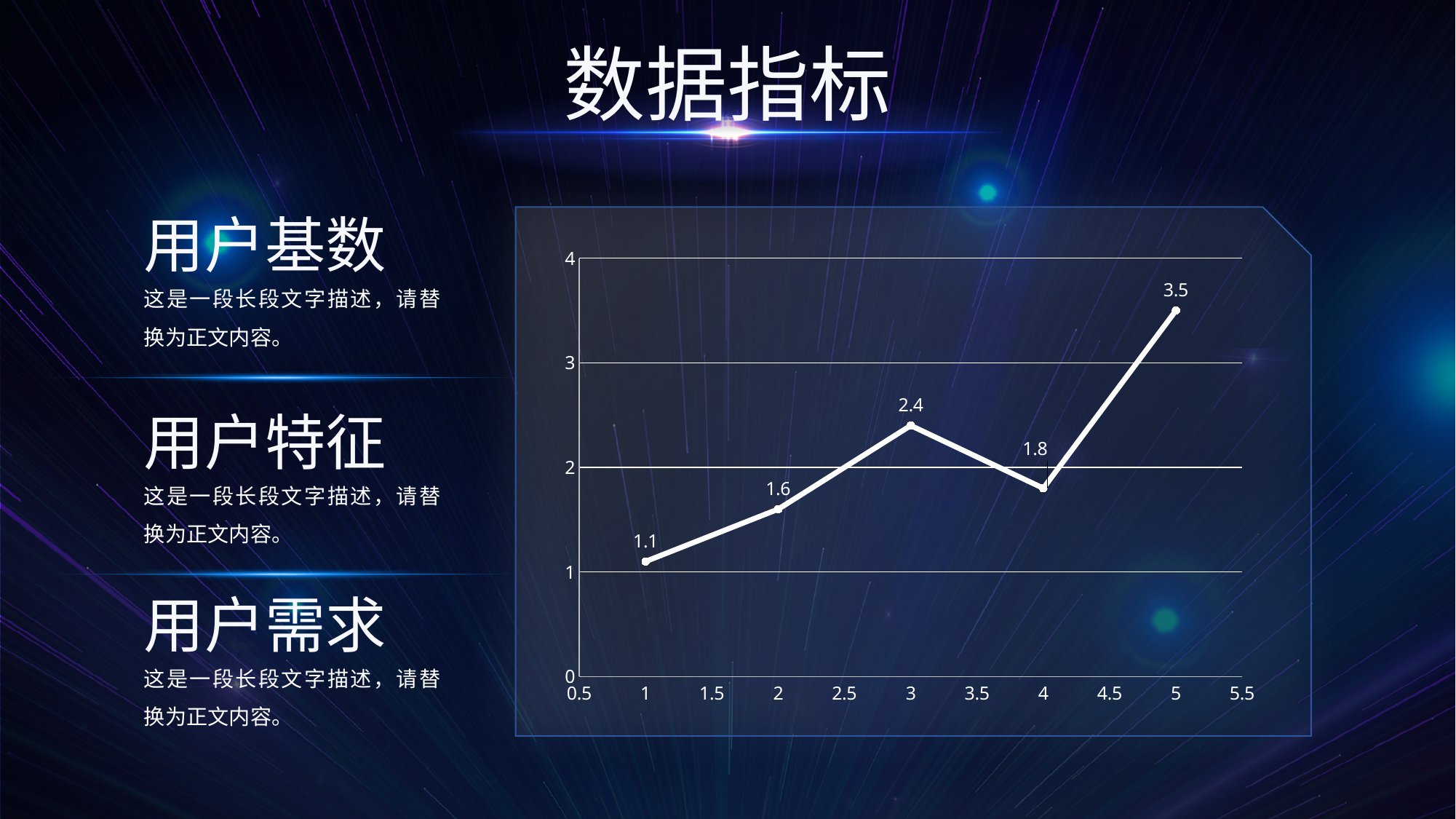
Does the plotted value rise or fall from x = 3 to x = 4? fall How many data points are plotted on the chart? 5 At which x value is the plotted value lowest? 1 What is the value plotted at x = 1? 1.1 Which is larger, the value at x = 3 or the value at x = 4? x = 3 What is the difference between the values at x = 5 and x = 4? 1.7 What is the difference between the values at x = 3 and x = 2? 0.8 Is the value at x = 4 greater or less than 2? less What is the value plotted at x = 3? 2.4 What is the value plotted at x = 5? 3.5 What kind of chart is shown on the slide? line chart At which x value is the plotted value highest? 5